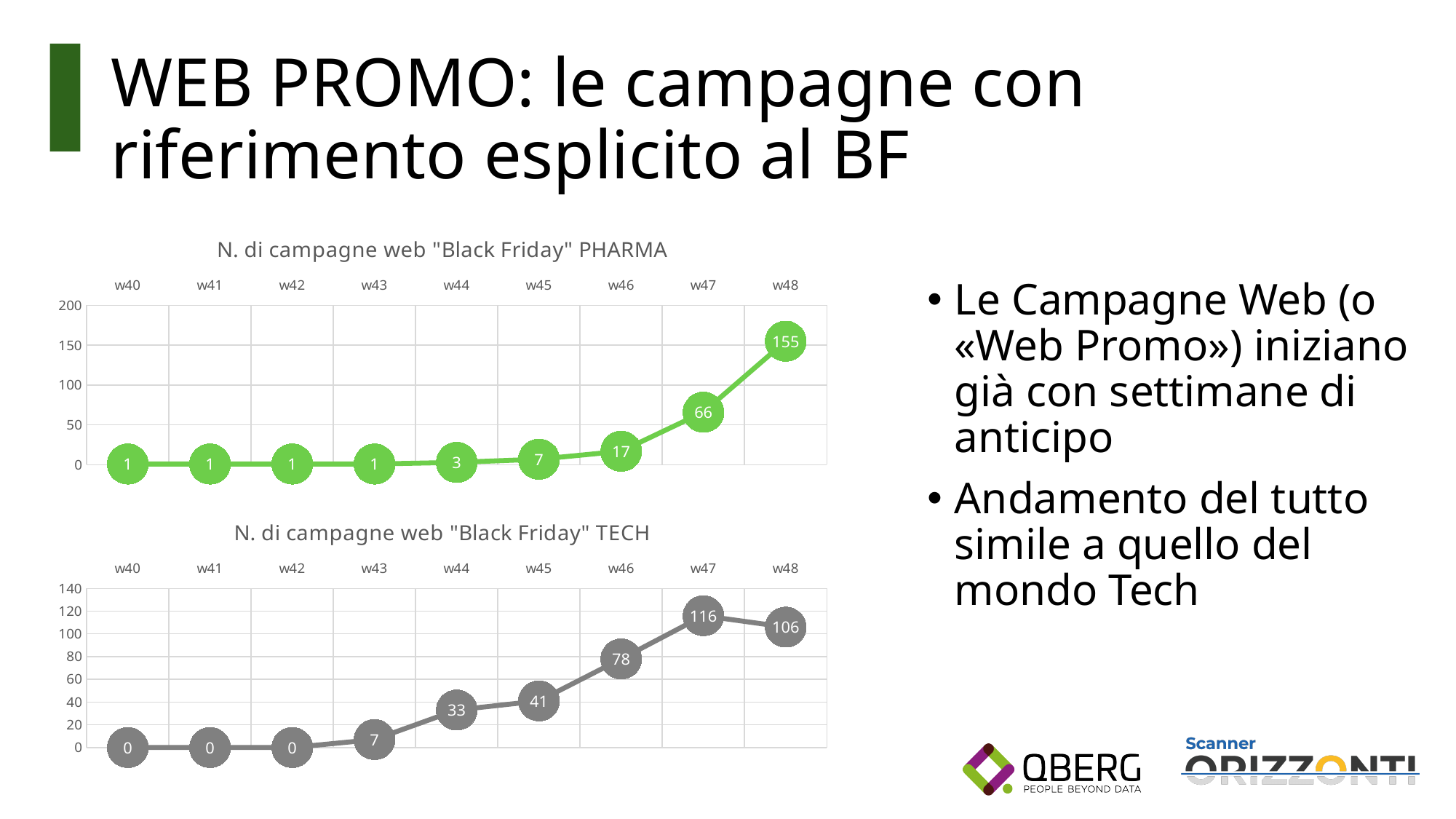
In the chart "N. di campagne web "Black Friday" TECH", which is larger, the value for w45 or the value for w46? w46 In the chart "N. di campagne web "Black Friday" PHARMA", what is the value for w46? 17 In the chart "N. di campagne web "Black Friday" PHARMA", what is the difference between the values for w48 and w47? 89 What kind of chart is "N. di campagne web "Black Friday" TECH"? Line chart In the chart "N. di campagne web "Black Friday" TECH", what is the difference between the values for w47 and w48? 10 In the chart "N. di campagne web "Black Friday" PHARMA", what is the value for w48? 155 In the chart "N. di campagne web "Black Friday" TECH", what is the value for w47? 116 How many weeks are plotted in the chart "N. di campagne web "Black Friday" PHARMA"? 9 In the chart "N. di campagne web "Black Friday" PHARMA", do the values rise or fall from w44 to w48? Rise In the chart "N. di campagne web "Black Friday" PHARMA", which week has the highest value? w48 In the chart "N. di campagne web "Black Friday" TECH", which week has the highest value? w47 In the chart "N. di campagne web "Black Friday" TECH", what is the value for w44? 33